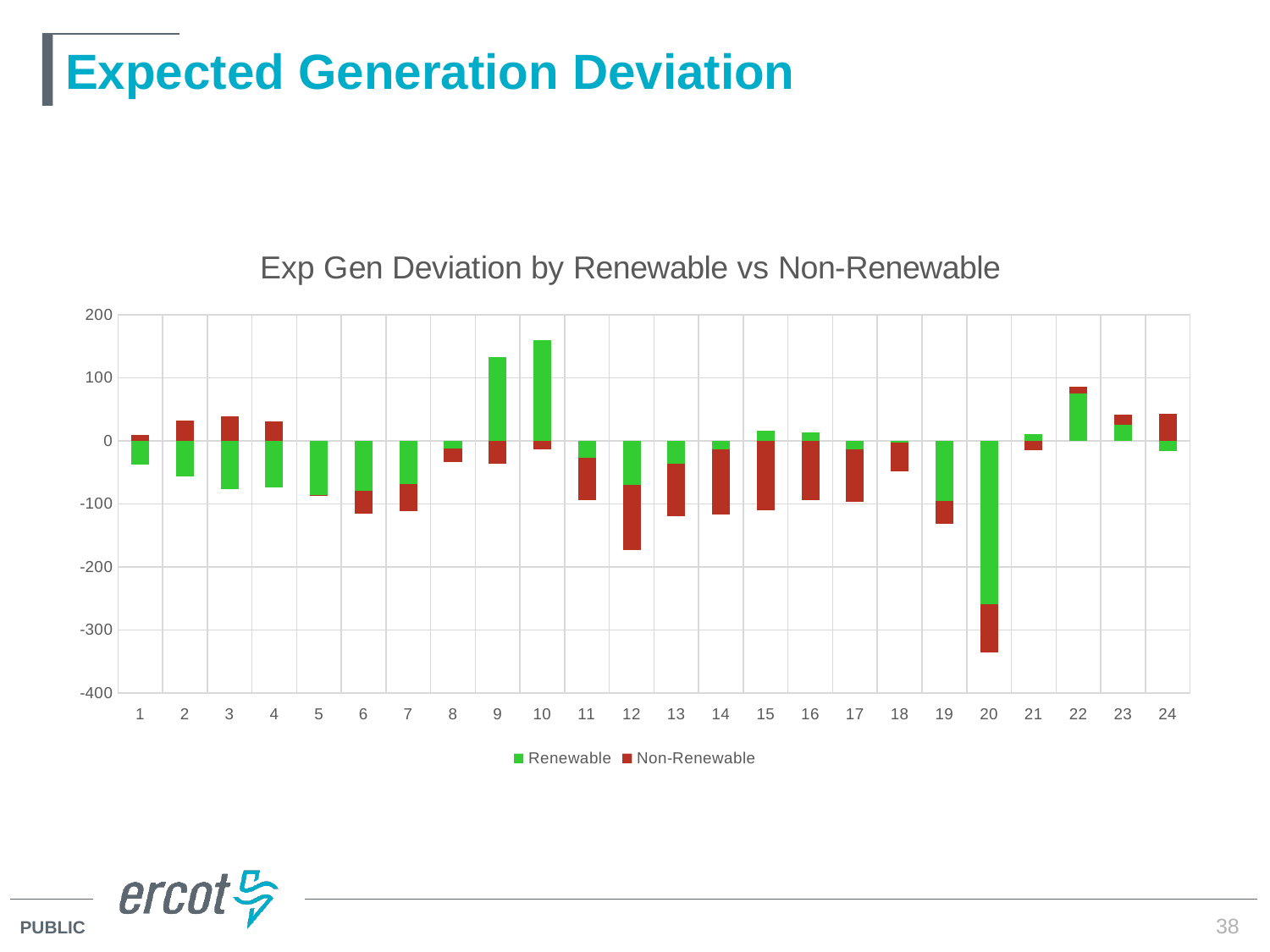
How many series does the chart legend list? 2 Which category has the lowest (most negative) Renewable value? 20 What is the title of the chart? Exp Gen Deviation by Renewable vs Non-Renewable Which is larger, the Renewable value for category 9 or for category 10? Category 10 Which category has the most negative total stacked bar? 20 Is the total stacked value for category 12 greater or less than -100? less Which colour represents the Renewable series in the chart? Green Is the Renewable value for category 20 greater or less than -200? less What kind of chart is shown on the slide? Stacked bar chart Which category has the highest positive Renewable value? 10 How many categories are shown along the x axis of the chart? 24 Is the Renewable value for category 10 greater or less than 100? greater